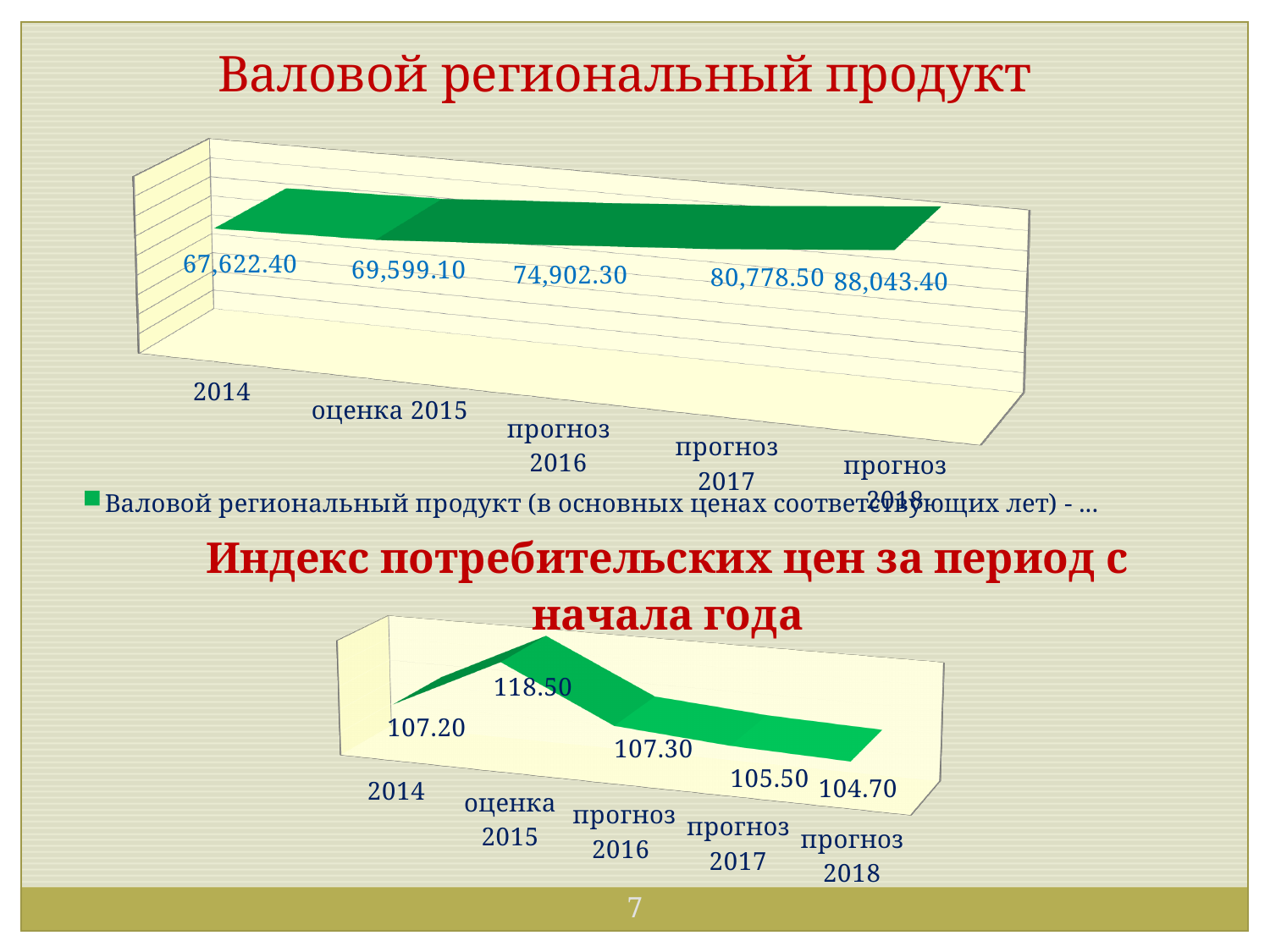
On the chart titled "Индекс потребительских цен за период с начала года", what is the value for оценка 2015? 118.50 On the chart titled "Валовой региональный продукт", what is the difference between the values for прогноз 2017 and прогноз 2016? 5,876.20 On the chart titled "Валовой региональный продукт", how many categories are shown on the x axis? 5 On the chart titled "Валовой региональный продукт", do the values rise or fall from 2014 to прогноз 2018? rise On the chart titled "Индекс потребительских цен за период с начала года", which is larger: the value for 2014 or the value for прогноз 2016? прогноз 2016 What kind of chart is the chart titled "Индекс потребительских цен за период с начала года"? line chart On the chart titled "Индекс потребительских цен за период с начала года", which category has the lowest value? прогноз 2018 On the chart titled "Валовой региональный продукт", what is the value for прогноз 2018? 88,043.40 On the chart titled "Индекс потребительских цен за период с начала года", what is the value for прогноз 2018? 104.70 On the chart titled "Валовой региональный продукт", which category has the highest value? прогноз 2018 On the chart titled "Индекс потребительских цен за период с начала года", what is the difference between the values for оценка 2015 and прогноз 2016? 11.20 On the chart titled "Валовой региональный продукт", what is the value for 2014? 67,622.40